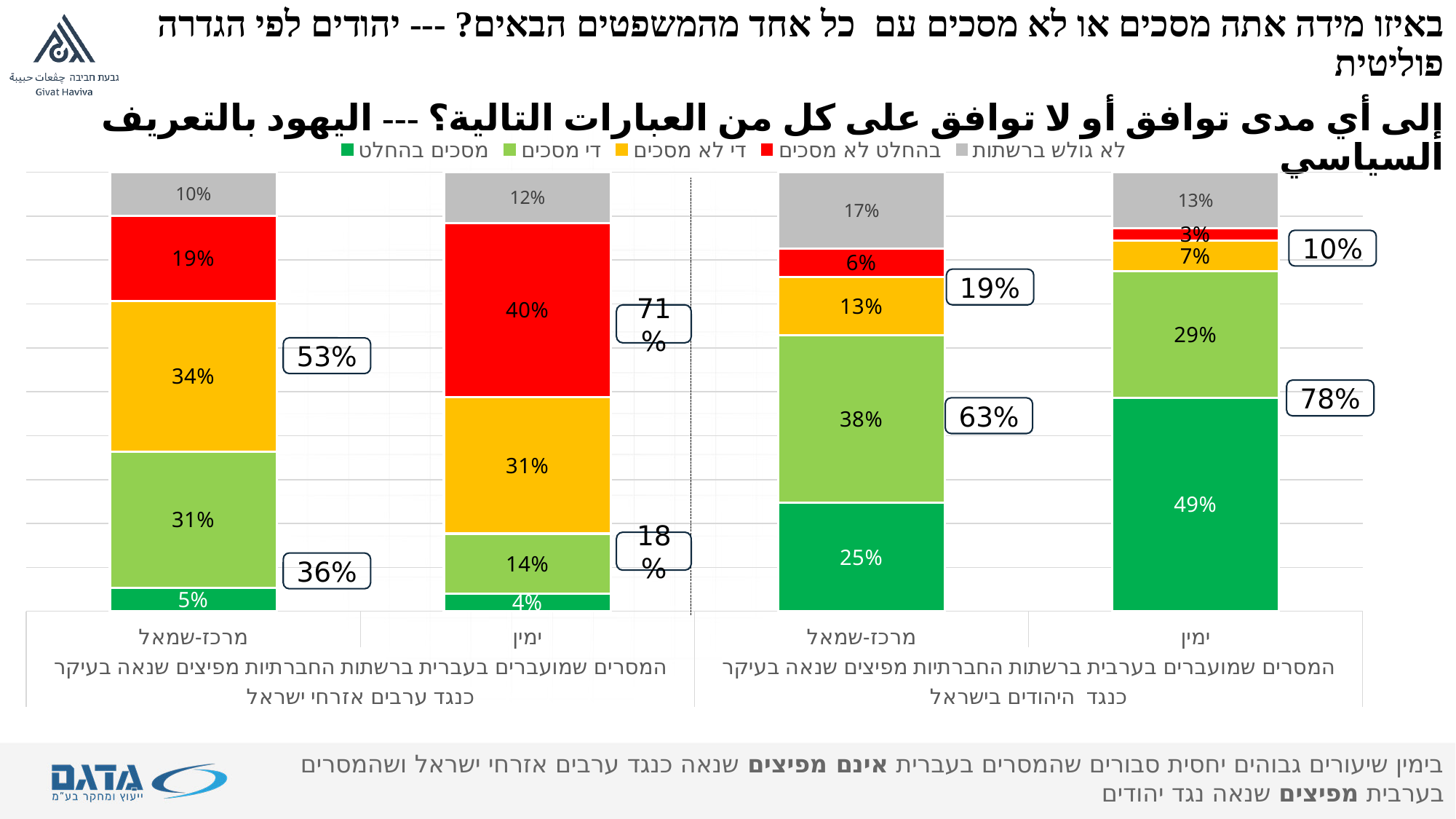
In the right panel (messages in Arabic spreading hatred against Jews in Israel), what is the value of לא גולש ברשתות for מרכז-שמאל? 17% What kind of chart is shown on the slide? Stacked bar chart In the right panel, what is the combined share of מסכים בהחלט and די מסכים for ימין, as shown in the callout? 78% Which colour represents the series לא גולש ברשתות in the legend? Gray In the right panel (messages in Arabic spreading hatred against Jews in Israel), what is the value of מסכים בהחלט for ימין? 49% In the left panel (messages in Hebrew spreading hatred against Arab citizens of Israel), what is the value of די לא מסכים for מרכז-שמאל? 34% How many bars are plotted in the chart? 4 In the left panel (messages in Hebrew spreading hatred against Arab citizens of Israel), what is the value of בהחלט לא מסכים for ימין? 40% In the right panel, what is the difference between the מסכים בהחלט values for ימין and מרכז-שמאל? 24% How many series does the legend list? 5 In the left panel, which bar has the higher value for בהחלט לא מסכים, מרכז-שמאל or ימין? ימין In the left panel, what is the combined share of מסכים בהחלט and די מסכים for מרכז-שמאל, as shown in the callout? 36%